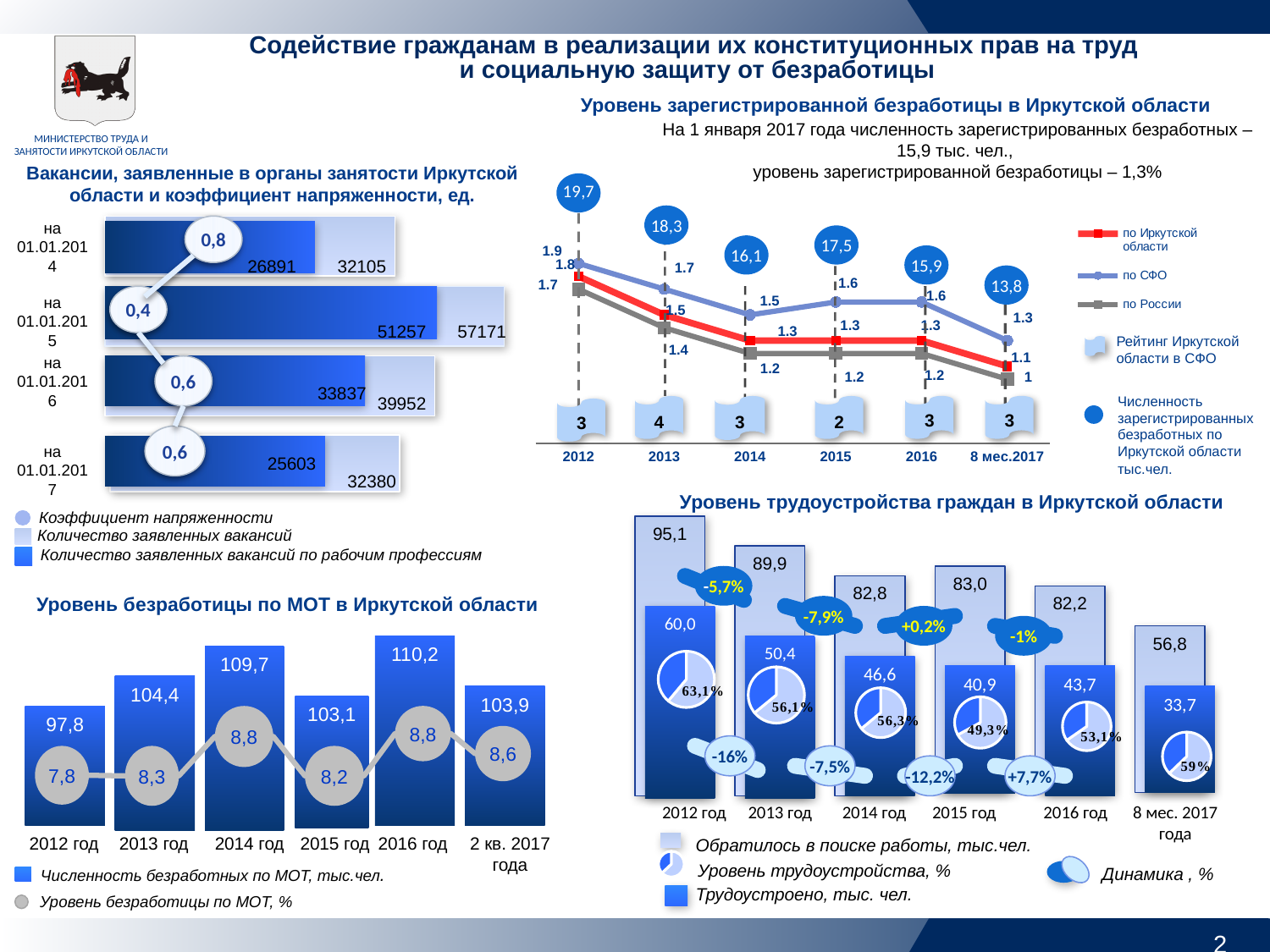
In the chart 'Уровень зарегистрированной безработицы в Иркутской области', what is the number of registered unemployed (тыс.чел.) in 2014? 16,1 In the chart 'Вакансии, заявленные в органы занятости Иркутской области и коэффициент напряженности, ед.', what is the difference between the number of declared vacancies and the number of vacancies for working professions as of 01.01.2017? 6777 In the chart 'Уровень зарегистрированной безработицы в Иркутской области', how many series does the legend list as lines? 3 In the chart 'Уровень трудоустройства граждан в Иркутской области', which is larger: the number of people who applied for work (Обратилось в поиске работы) in 2012 год or in 2013 год? 2012 год In the chart 'Уровень безработицы по МОТ в Иркутской области', how many time periods are shown on the x axis? 6 In the chart 'Вакансии, заявленные в органы занятости Иркутской области и коэффициент напряженности, ед.', what is the number of declared vacancies (Количество заявленных вакансий) as of 01.01.2015? 57171 In the chart 'Уровень трудоустройства граждан в Иркутской области', what is the employment rate (Уровень трудоустройства, %) for 2015 год? 49,3% In the chart 'Уровень безработицы по МОТ в Иркутской области', what is the ILO unemployment rate (%) in 2015? 8,2 In the chart 'Уровень зарегистрированной безработицы в Иркутской области', in which year was the rating of Irkutsk region in SFO equal to 2? 2015 In the chart 'Вакансии, заявленные в органы занятости Иркутской области и коэффициент напряженности, ед.', which date has the lowest коэффициент напряженности? на 01.01.2015 In the chart 'Уровень безработицы по МОТ в Иркутской области', which year has the highest number of unemployed by ILO (тыс.чел.)? 2016 год In the chart 'Уровень зарегистрированной безработицы в Иркутской области', what is the registered unemployment rate for Irkutsk region (по Иркутской области) in 2013? 1.5